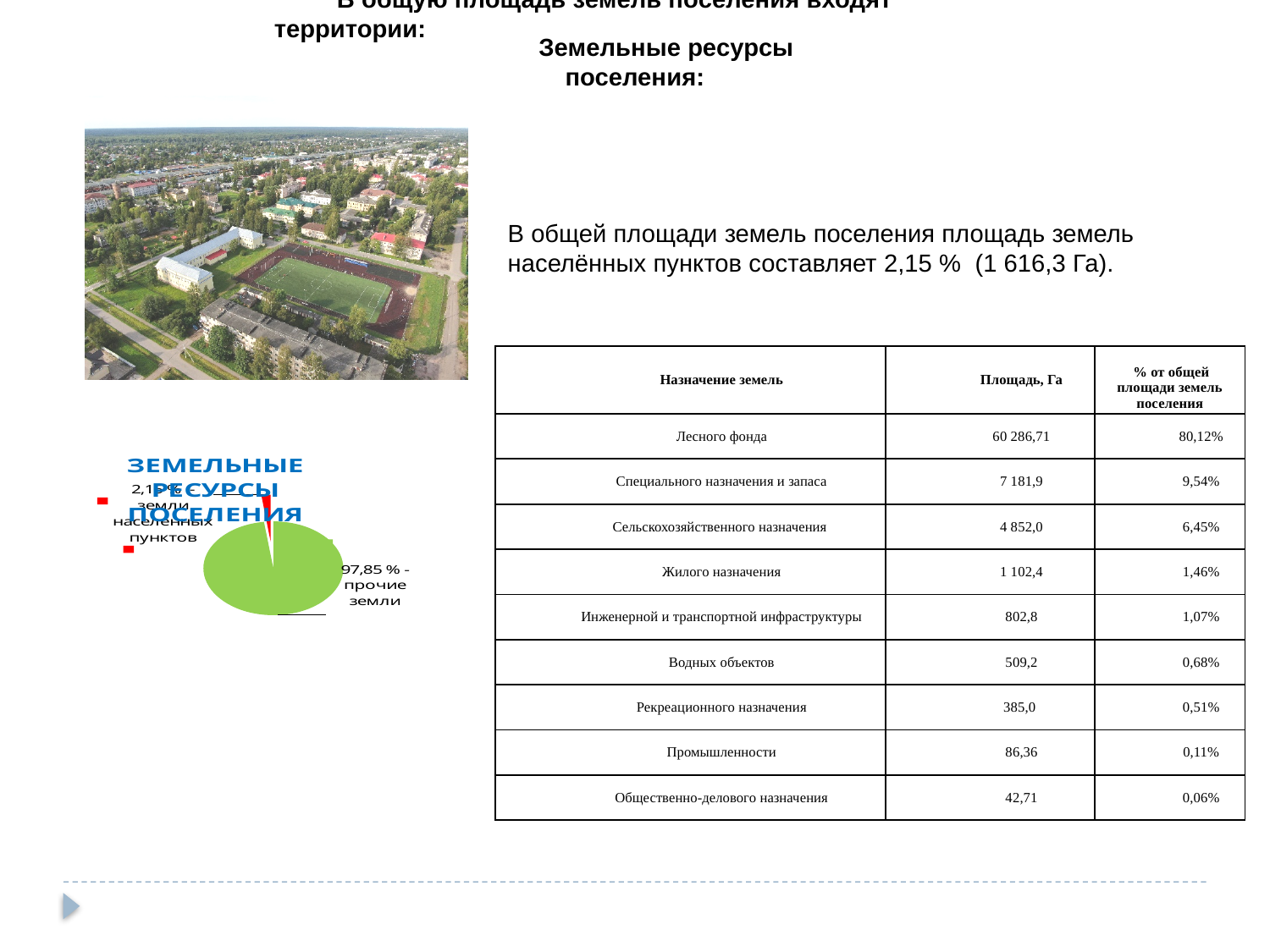
In the pie chart, what share is labelled for земли населённых пунктов? 2,15 % What is the title of the pie chart? ЗЕМЕЛЬНЫЕ РЕСУРСЫ ПОСЕЛЕНИЯ What kind of chart is shown on the left of the slide? pie chart In the pie chart, which is larger: the share for прочие земли or the share for земли населённых пунктов? прочие земли Which slice of the pie chart is the largest? прочие земли Which slice of the pie chart is the smallest? земли населённых пунктов How many slices does the pie chart have? 2 What is the difference in percentage points between the two slices of the pie chart? 95,7 What colour is the прочие земли slice in the pie chart? green In the pie chart, what share is labelled for прочие земли? 97,85 %